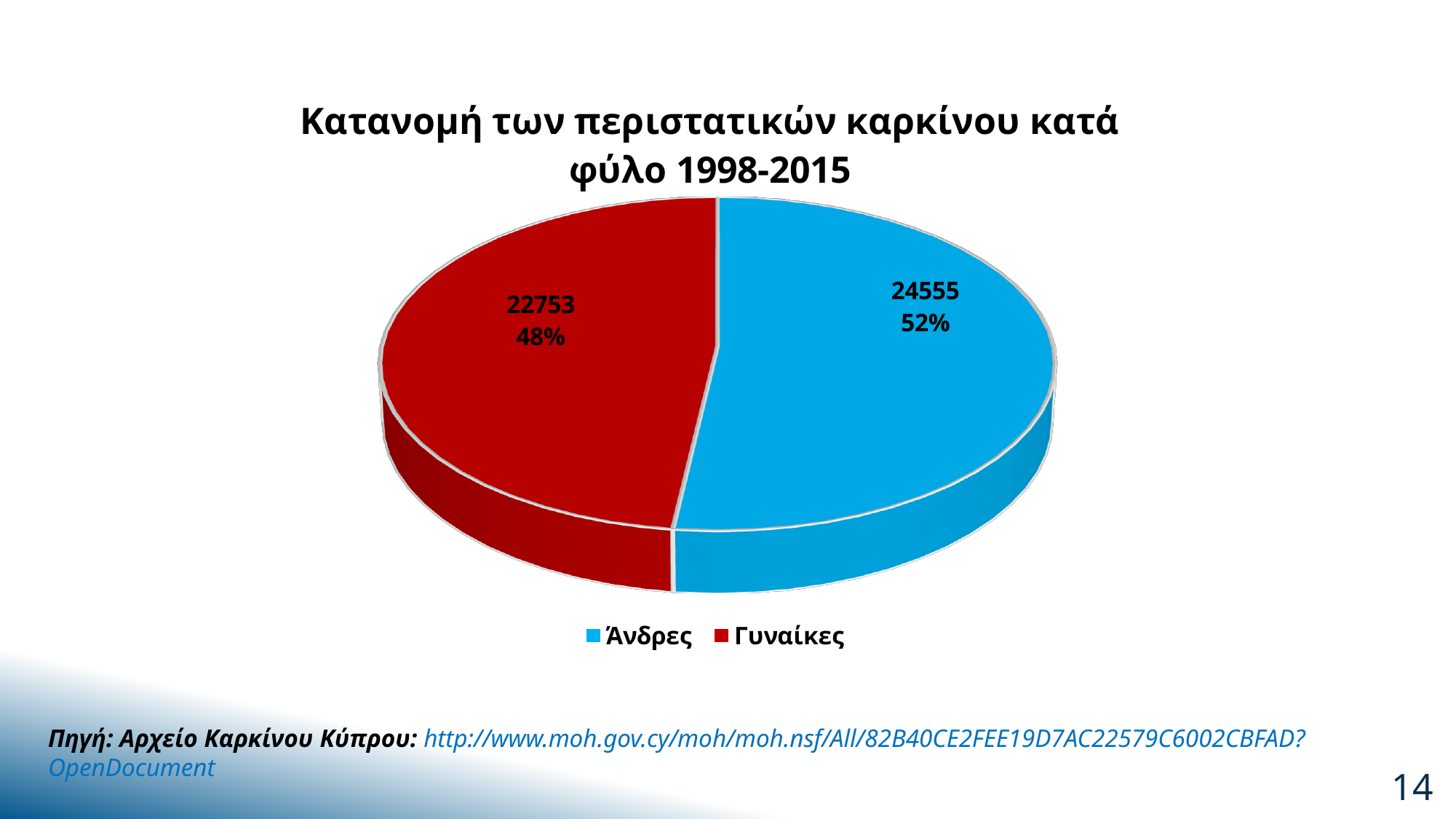
Which is larger, the value for Άνδρες or the value for Γυναίκες? Άνδρες How many categories does the pie chart have? 2 What kind of chart is shown on the slide? pie chart What is the value for Γυναίκες? 22753 What is the title of the chart? Κατανομή των περιστατικών καρκίνου κατά φύλο 1998-2015 What share of the pie does Άνδρες represent? 52% What colour is the slice for Γυναίκες? red What share of the pie does Γυναίκες represent? 48% What is the difference between the values for Άνδρες and Γυναίκες? 1802 Which category has the largest slice? Άνδρες Which category has the smallest slice? Γυναίκες What is the value for Άνδρες? 24555